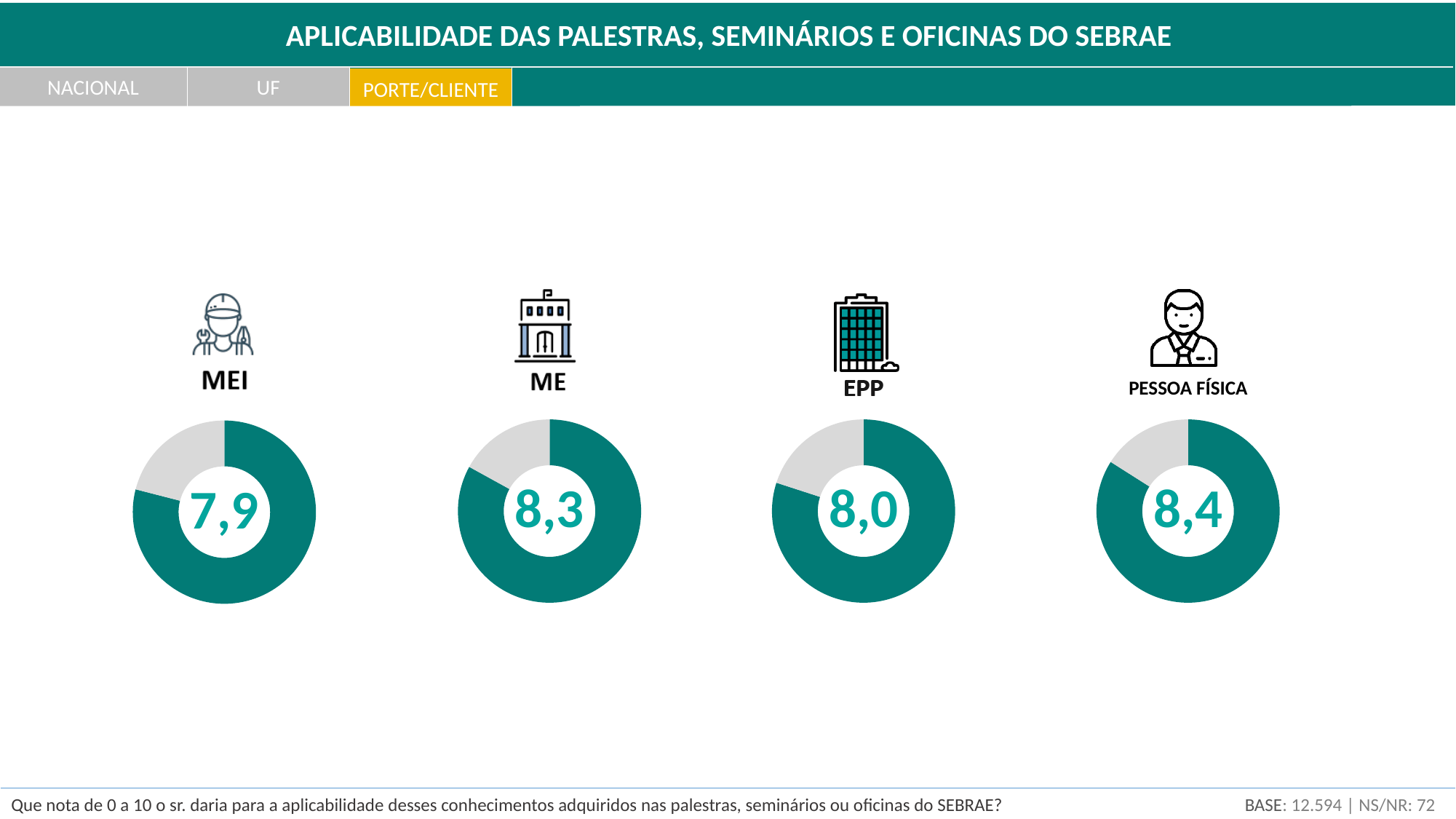
What kind of chart is used to display each group's score? Donut chart What is the difference between the PESSOA FÍSICA score and the EPP score? 0,4 Which group has the lowest score among the four donut charts? MEI What is the title of the slide containing the donut charts? APLICABILIDADE DAS PALESTRAS, SEMINÁRIOS E OFICINAS DO SEBRAE What is the difference between the ME score and the MEI score? 0,4 What score is shown in the MEI donut chart? 7,9 What score is shown in the PESSOA FÍSICA donut chart? 8,4 What score is shown in the EPP donut chart? 8,0 How many donut charts are shown on the slide? 4 Which group has the highest score among the four donut charts? PESSOA FÍSICA Which has a higher score, ME or EPP? ME What score is shown in the ME donut chart? 8,3